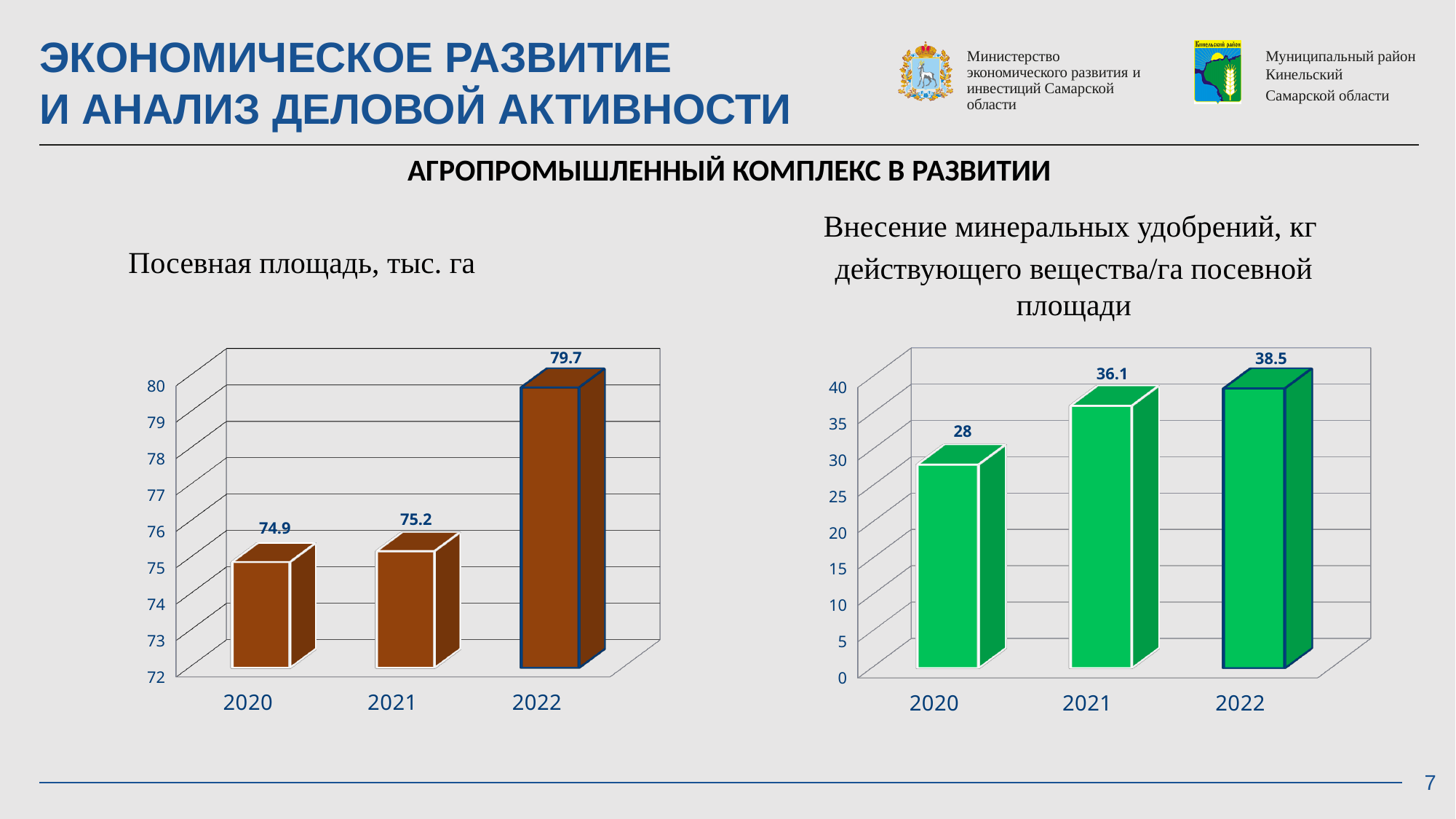
In the right chart (Внесение минеральных удобрений), what is the value for 2021? 36.1 What colour are the bars in the right chart (Внесение минеральных удобрений)? green In the right chart (Внесение минеральных удобрений), is the value for 2020 greater or less than 30? less In the right chart (Внесение минеральных удобрений), what is the difference between the 2022 and 2020 values? 10.5 In the left chart (Посевная площадь, тыс. га), which year has the lowest value? 2020 In the left chart (Посевная площадь, тыс. га), do the values rise or fall from 2020 to 2022? rise In the left chart (Посевная площадь, тыс. га), what is the value for 2020? 74.9 In the right chart (Внесение минеральных удобрений), how many years are shown on the x axis? 3 What kind of chart is the left chart (Посевная площадь, тыс. га)? bar chart In the left chart (Посевная площадь, тыс. га), what is the difference between the 2022 and 2021 values? 4.5 In the right chart (Внесение минеральных удобрений), which year has the highest value? 2022 In the left chart (Посевная площадь, тыс. га), what is the value for 2022? 79.7